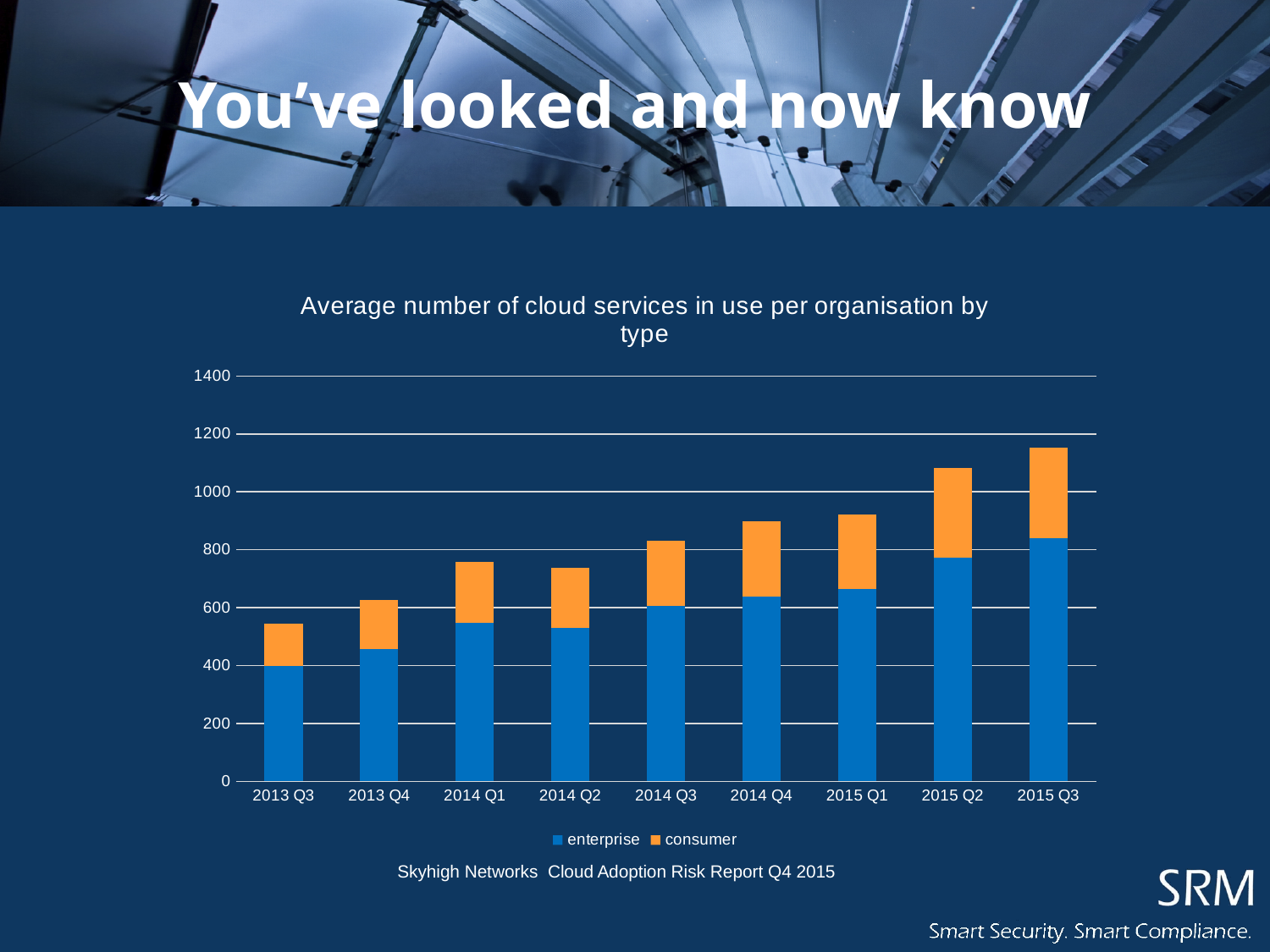
Which quarter has the lowest total number of cloud services in use? 2013 Q3 How many series does the chart's legend list? 2 Is the enterprise value for 2014 Q4 greater or less than 600? greater What kind of chart is shown on the slide? Stacked bar chart Is the total value for 2015 Q3 greater or less than 1000? greater How many quarters are shown on the x axis of the chart? 9 What are the two series named in the chart's legend? enterprise and consumer Which quarter has the highest total number of cloud services in use? 2015 Q3 Is the total value for 2014 Q2 greater or less than 800? less Do the total values generally rise or fall from 2013 Q3 to 2015 Q3? rise Which has the larger total, 2015 Q2 or 2014 Q4? 2015 Q2